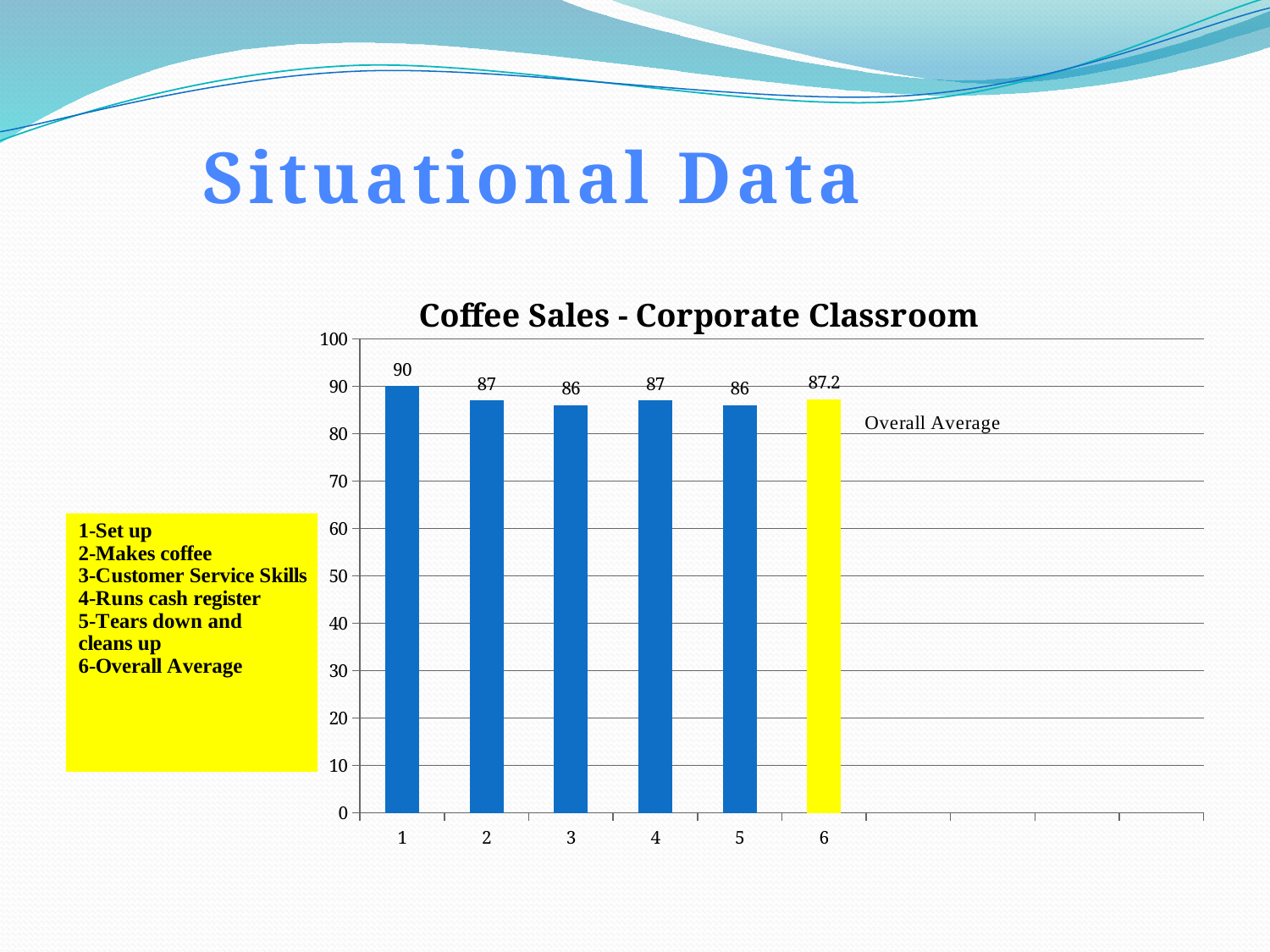
Is the value for category 2 in the Coffee Sales - Corporate Classroom chart greater or less than 80? greater What kind of chart is shown on the slide? bar chart What is the title of the chart on the slide? Coffee Sales - Corporate Classroom What colour is the bar for category 6 (Overall Average) in the Coffee Sales - Corporate Classroom chart? yellow What is the value for category 6 (Overall Average) in the Coffee Sales - Corporate Classroom chart? 87.2 What is the difference between the values for category 1 and category 2 in the Coffee Sales - Corporate Classroom chart? 3 Which category has the highest value in the Coffee Sales - Corporate Classroom chart? 1 What is the value for category 3 in the Coffee Sales - Corporate Classroom chart? 86 Which is larger in the Coffee Sales - Corporate Classroom chart, the value for category 1 or the value for category 4? category 1 How many bars are plotted in the Coffee Sales - Corporate Classroom chart? 6 What is the value for category 1 in the Coffee Sales - Corporate Classroom chart? 90 What is the difference between the values for category 6 and category 5 in the Coffee Sales - Corporate Classroom chart? 1.2